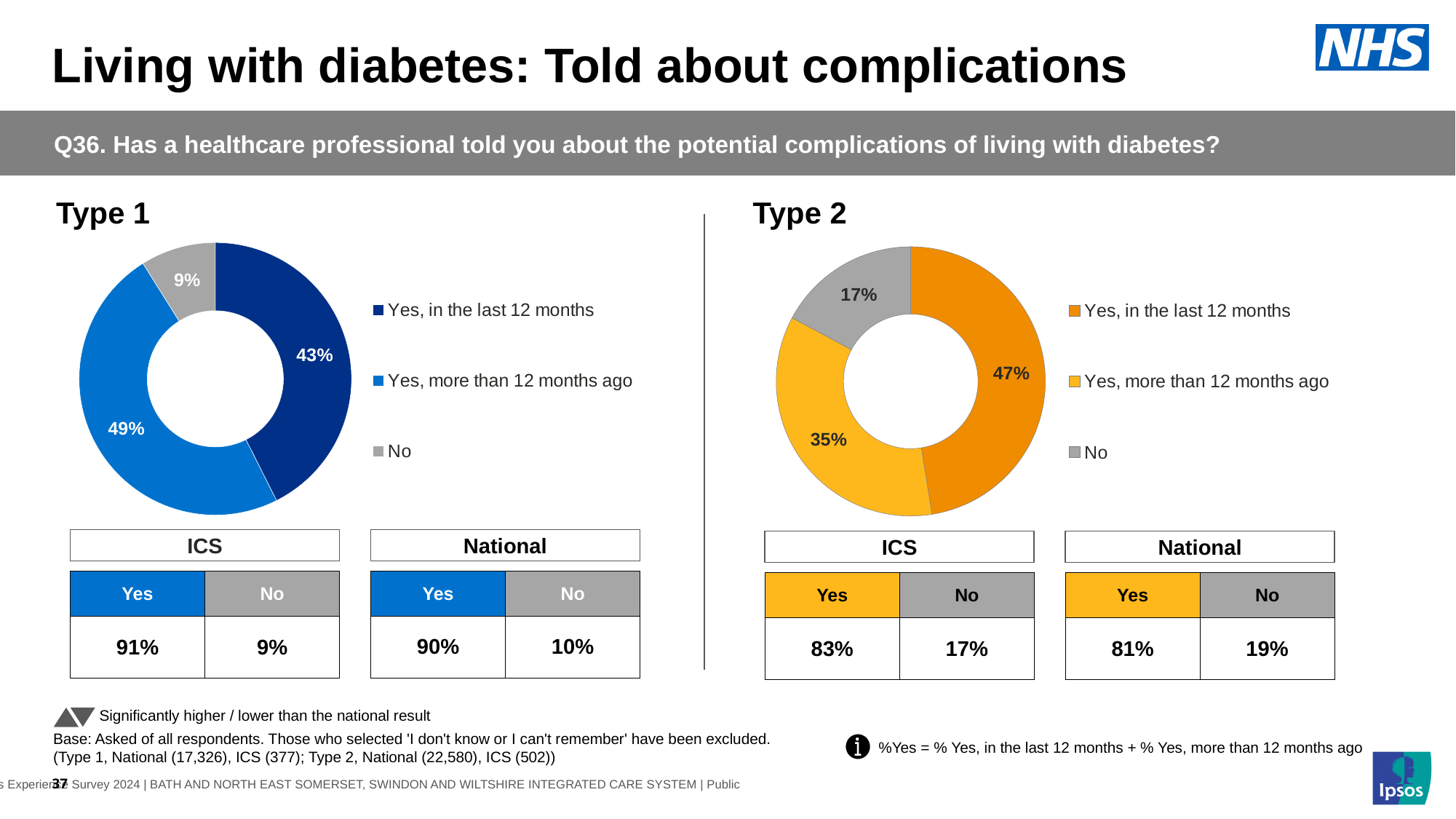
In the Type 2 chart, what percentage of respondents said 'Yes, in the last 12 months'? 47% In the Type 2 chart, what percentage of respondents said 'No'? 17% In the Type 1 chart, what is the combined share of the two 'Yes' categories? 92% In the Type 2 chart, what is the difference between 'Yes, in the last 12 months' and 'Yes, more than 12 months ago'? 12% How many categories does the Type 2 chart show? 3 What kind of chart is used for Type 1? Doughnut chart In the Type 2 chart, which category has the largest share? Yes, in the last 12 months In the Type 1 chart, what percentage of respondents said 'Yes, more than 12 months ago'? 49% In the Type 1 chart, which category has the smallest share? No In the Type 2 chart, what colour represents 'No'? Grey In the Type 1 chart, what percentage of respondents said 'Yes, in the last 12 months'? 43% In the Type 1 chart, which is larger: 'Yes, in the last 12 months' or 'Yes, more than 12 months ago'? Yes, more than 12 months ago